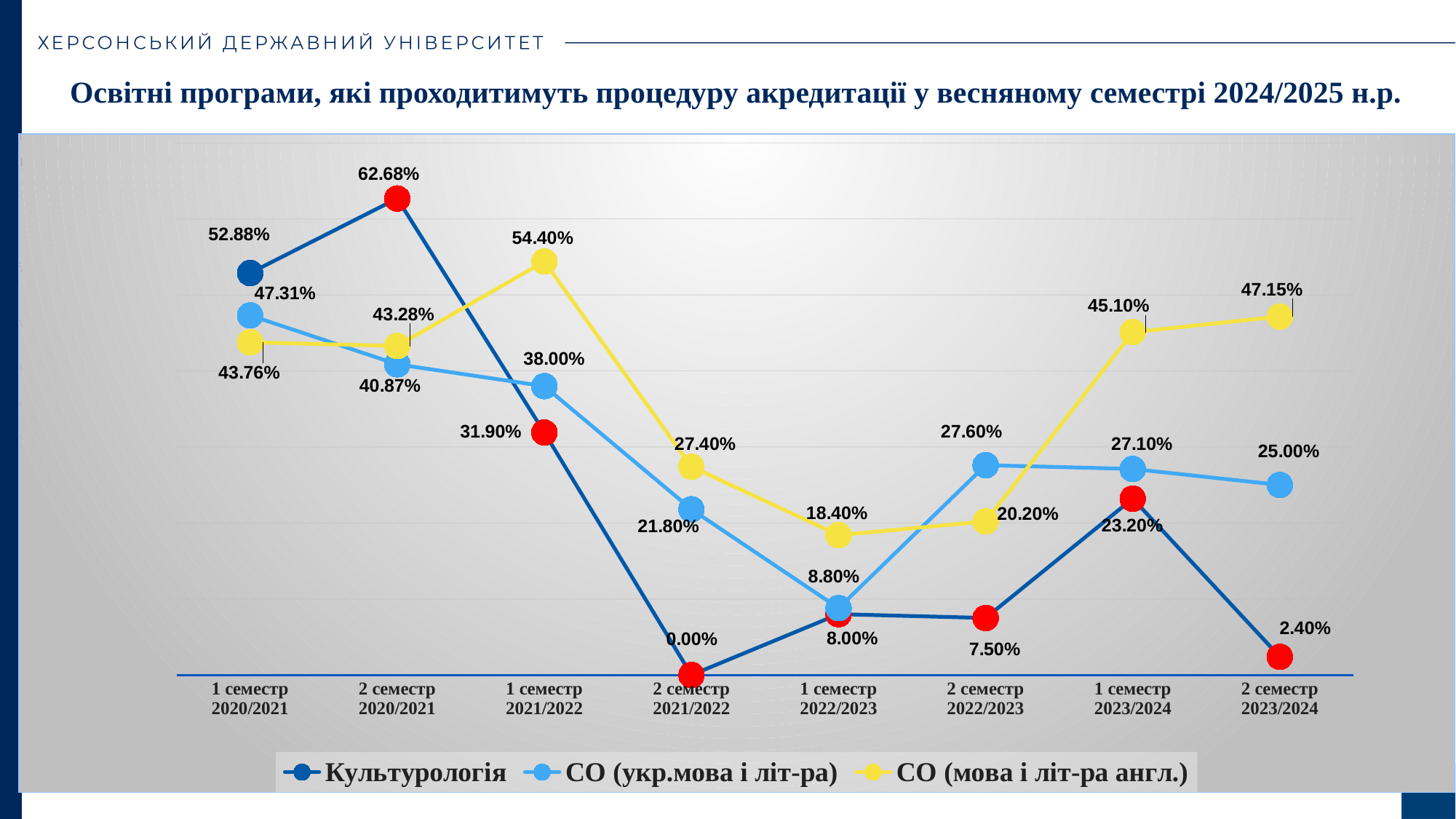
What is the difference between СО (мова і літ-ра англ.) and СО (укр.мова і літ-ра) in 2 семестр 2023/2024? 22.15% In which semester does Культурологія have its lowest value? 2 семестр 2021/2022 What is the value for СО (мова і літ-ра англ.) in 1 семестр 2021/2022? 54.40% What is the difference between the Культурологія values in 2 семестр 2020/2021 and 1 семестр 2020/2021? 9.80% Does the value for СО (укр.мова і літ-ра) rise or fall from 1 семестр 2020/2021 to 1 семестр 2022/2023? fall What is the value for Культурологія in 2 семестр 2020/2021? 62.68% What is the value for СО (укр.мова і літ-ра) in 2 семестр 2022/2023? 27.60% Which series has the highest value in 2 семестр 2023/2024? СО (мова і літ-ра англ.) What type of chart is shown on the slide? line chart How many semesters are shown along the x axis? 8 In which semester does Культурологія reach its highest value? 2 семестр 2020/2021 How many series does the legend list? 3